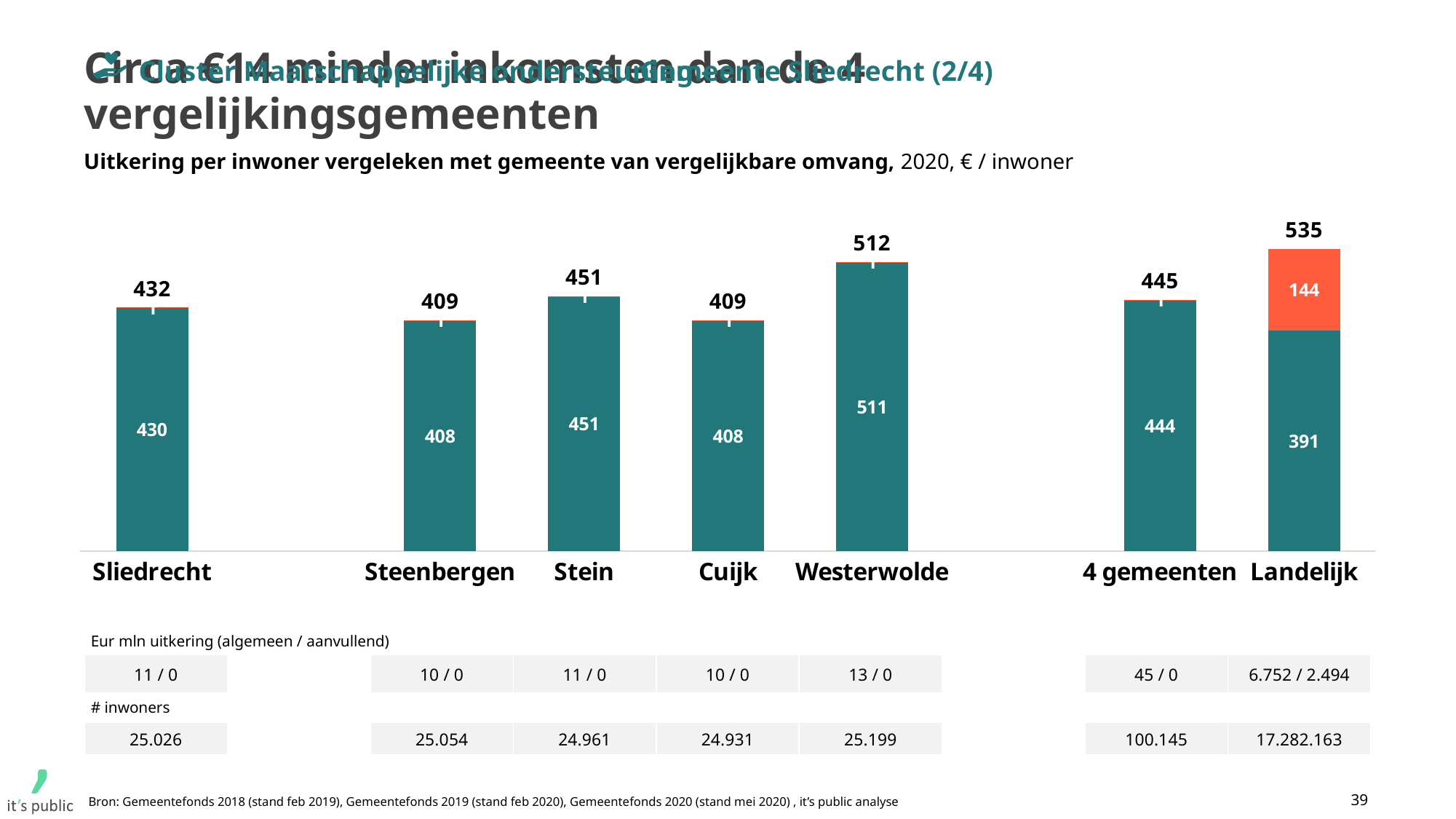
What is the value of the dark teal (bottom) segment of the Westerwolde bar? 511 What type of chart is shown on the slide? Stacked bar chart What is the difference between the total for 4 gemeenten and the total for Sliedrecht? 13 How many bars are shown in the chart? 7 Which of the four comparison municipalities (Steenbergen, Stein, Cuijk, Westerwolde) has the lowest total value? Steenbergen and Cuijk (both 409) Which category has the highest total value? Landelijk What is the sum of the two segments of the Landelijk bar (391 and 144)? 535 Which is larger, the total for Stein or the total for Cuijk? Stein What is the total value shown above the bar for Landelijk? 535 What is the value of the orange (top) segment of the Landelijk bar? 144 What is the difference between the total for Westerwolde and the total for Sliedrecht? 80 What is the total value shown above the bar for Sliedrecht? 432